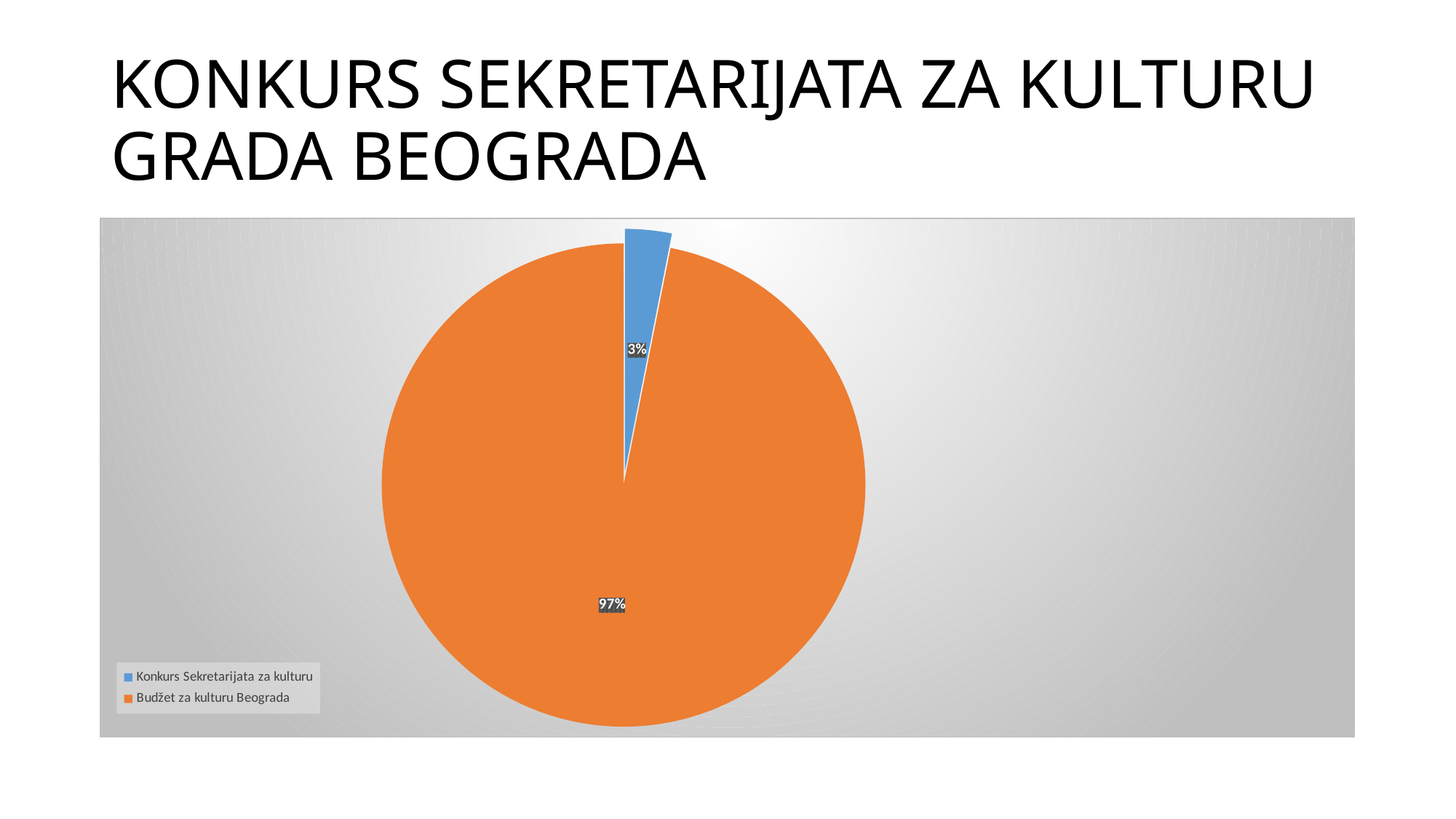
What share of the pie does "Konkurs Sekretarijata za kulturu" represent? 3% Which slice of the pie is the largest? Budžet za kulturu Beograda What is the difference in percentage points between the "Budžet za kulturu Beograda" slice and the "Konkurs Sekretarijata za kulturu" slice? 94 What colour is the "Konkurs Sekretarijata za kulturu" slice? blue Which is larger: the "Konkurs Sekretarijata za kulturu" slice or the "Budžet za kulturu Beograda" slice? Budžet za kulturu Beograda How many slices does the pie chart have? 2 What share of the pie does "Budžet za kulturu Beograda" represent? 97% How many entries does the legend list? 2 What colour is the "Budžet za kulturu Beograda" slice? orange Which slice of the pie is the smallest? Konkurs Sekretarijata za kulturu What kind of chart is shown on the slide? pie chart